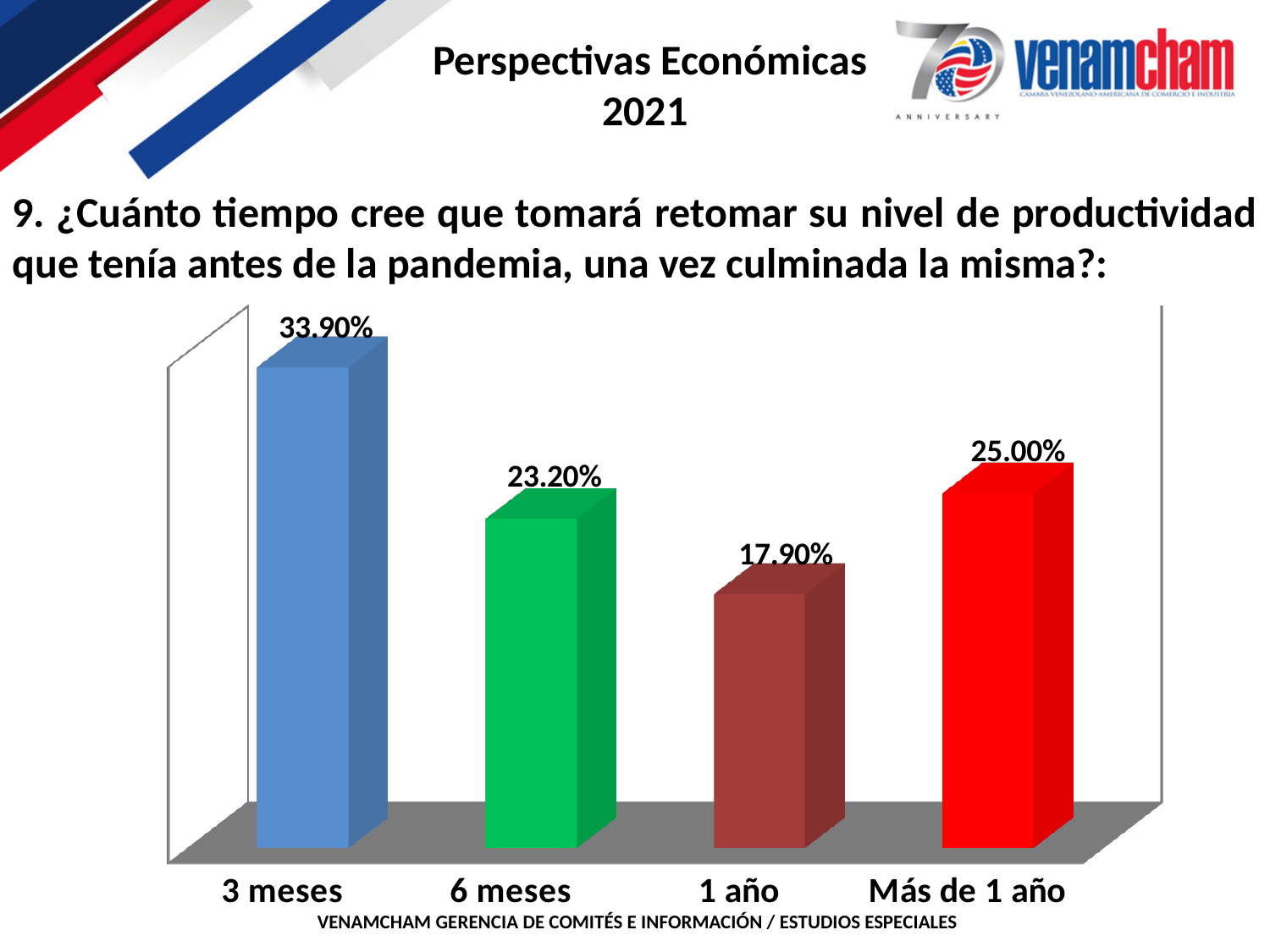
What is the value for "3 meses"? 33.90% How many categories are shown in the chart? 4 What is the value for "Más de 1 año"? 25.00% What is the value for "1 año"? 17.90% Which category has the lowest value? 1 año What kind of chart is shown on the slide? bar chart What is the value for "6 meses"? 23.20% What is the difference between the values for "3 meses" and "6 meses"? 10.70% What colour is the bar for "6 meses"? green What is the difference between the values for "Más de 1 año" and "1 año"? 7.10% Which is larger, the value for "6 meses" or the value for "Más de 1 año"? Más de 1 año Which category has the highest value? 3 meses